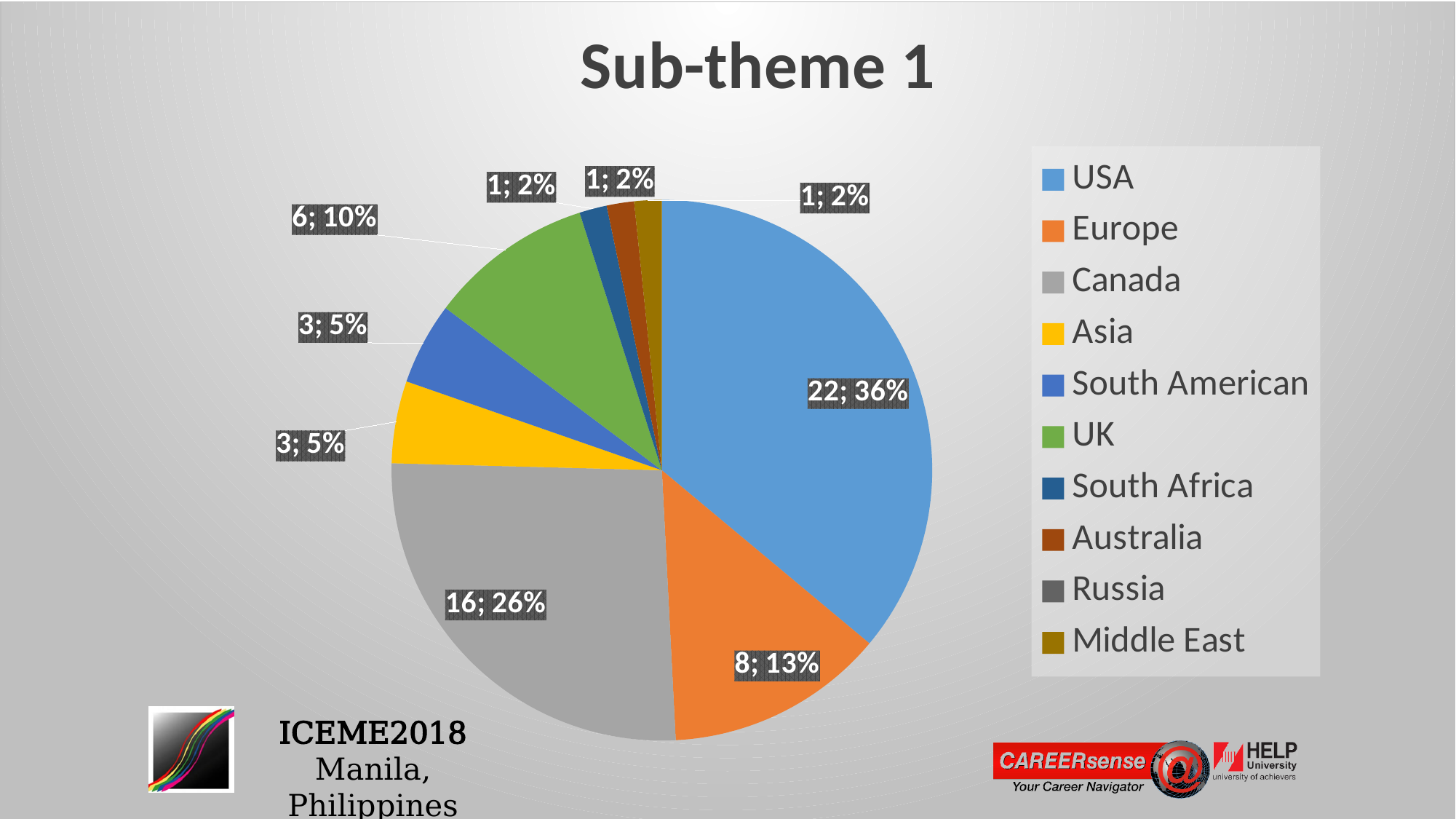
What is the title of the chart? Sub-theme 1 What kind of chart is shown on the slide? pie chart What is the value shown for USA? 22; 36% What is the value shown for Canada? 16; 26% What is the value shown for UK? 6; 10% What is the difference between the counts for USA and Canada? 6 What is the value shown for Europe? 8; 13% What colour is the slice for USA? blue What share of the pie does Canada represent? 26% How many categories does the legend list? 10 Which is larger, the slice for Europe or the slice for UK? Europe Which category has the largest slice of the pie? USA